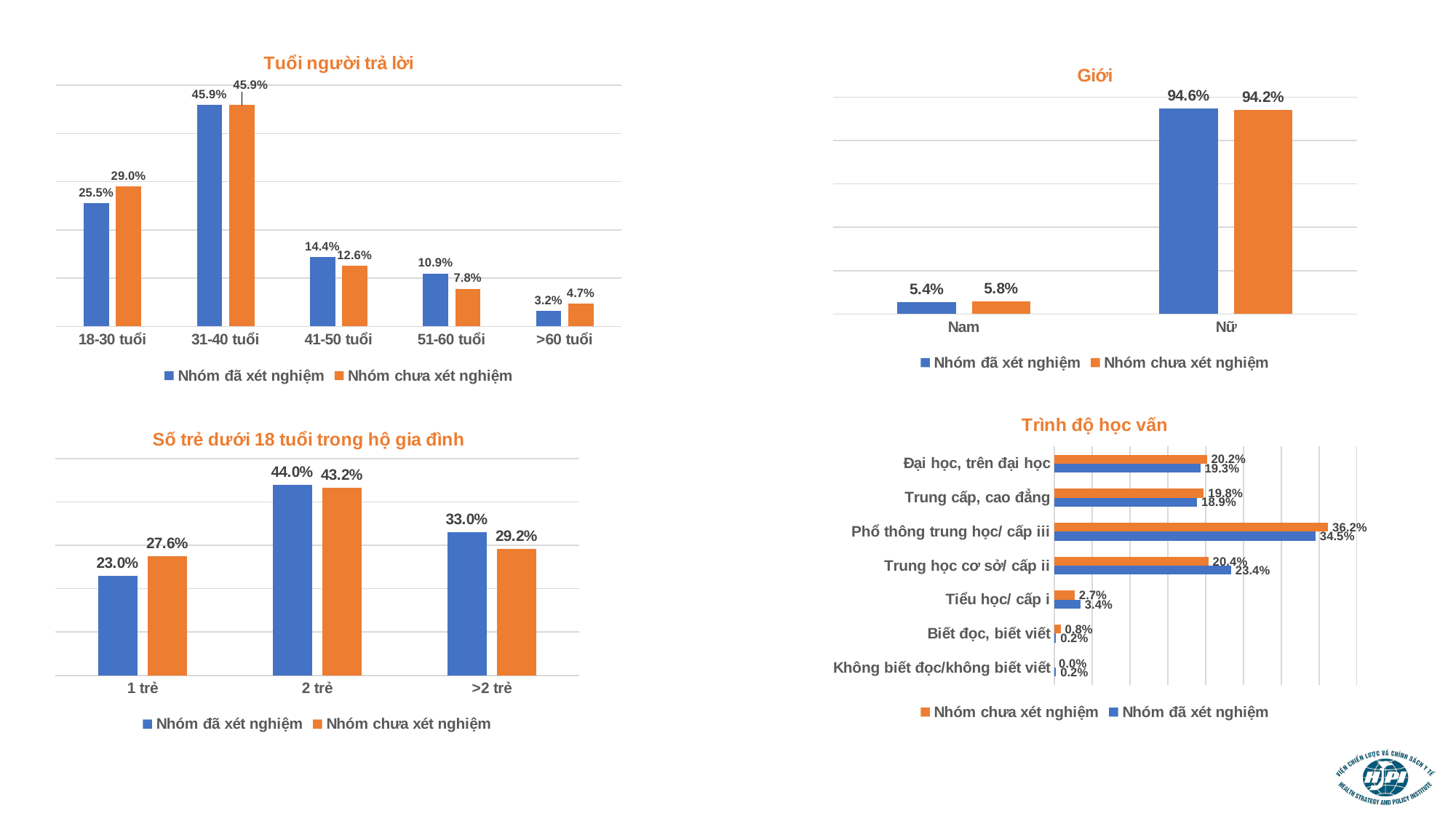
What type of chart is the 'Trình độ học vấn' chart? Bar chart In the 'Trình độ học vấn' chart, how many education categories are listed? 7 In the 'Số trẻ dưới 18 tuổi trong hộ gia đình' chart, which category has the lowest value for 'Nhóm đã xét nghiệm'? 1 trẻ In the 'Giới' chart, which is larger for Nam: 'Nhóm đã xét nghiệm' or 'Nhóm chưa xét nghiệm'? Nhóm chưa xét nghiệm In the 'Tuổi người trả lời' chart, how many age categories are shown on the x axis? 5 In the 'Số trẻ dưới 18 tuổi trong hộ gia đình' chart, what is the value for 'Nhóm đã xét nghiệm' for 2 trẻ? 44.0% In the 'Trình độ học vấn' chart, what is the value for 'Nhóm chưa xét nghiệm' for 'Phổ thông trung học/ cấp iii'? 36.2% In the 'Giới' chart, what is the value for 'Nhóm chưa xét nghiệm' for Nữ? 94.2% In the 'Tuổi người trả lời' chart, what is the value for 'Nhóm đã xét nghiệm' in the 18-30 tuổi category? 25.5% In the 'Số trẻ dưới 18 tuổi trong hộ gia đình' chart, what is the difference between 'Nhóm đã xét nghiệm' and 'Nhóm chưa xét nghiệm' for >2 trẻ? 3.8% In the 'Tuổi người trả lời' chart, what is the difference between 'Nhóm chưa xét nghiệm' and 'Nhóm đã xét nghiệm' for 18-30 tuổi? 3.5% In the 'Tuổi người trả lời' chart, which age category has the highest value for 'Nhóm chưa xét nghiệm'? 31-40 tuổi